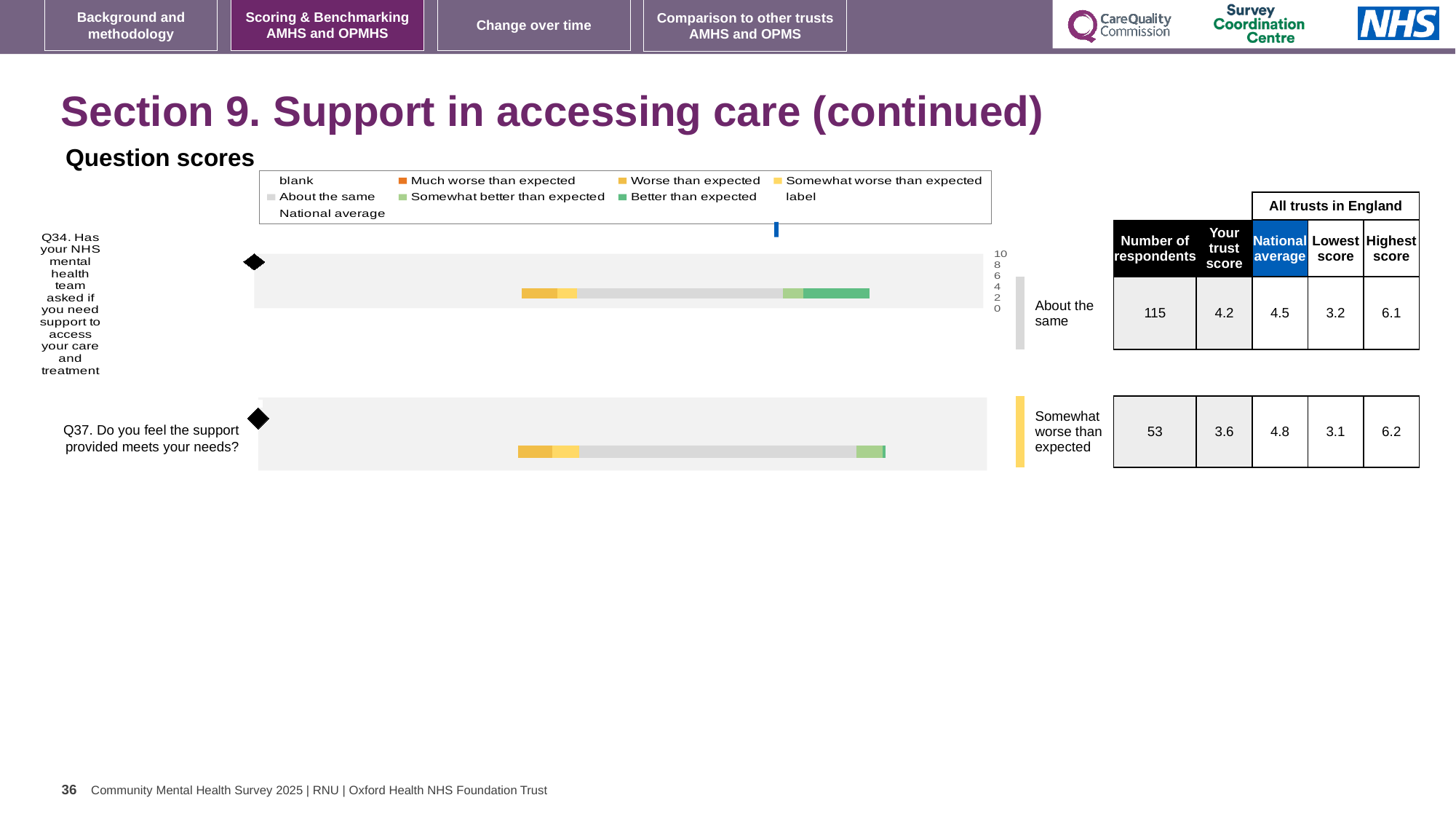
Which benchmark category is shown for Q34 (Has your NHS mental health team asked if you need support to access your care and treatment)? About the same For Q37, what is the difference between the national average and the trust score? 1.2 For Q34, is the trust score or the national average higher? National average Which benchmark category is shown for Q37 (Do you feel the support provided meets your needs)? Somewhat worse than expected In the chart legend, what colour represents 'Better than expected'? Green What is the highest score across all trusts in England for Q37? 6.2 What kind of chart is used to show the question scores on this slide? bar chart What is the national average for Q37? 4.8 How many respondents answered Q34? 115 What is the trust score for Q37 shown alongside the chart? 3.6 What is the trust score for Q34 shown alongside the chart? 4.2 How many questions are plotted in the question scores chart? 2